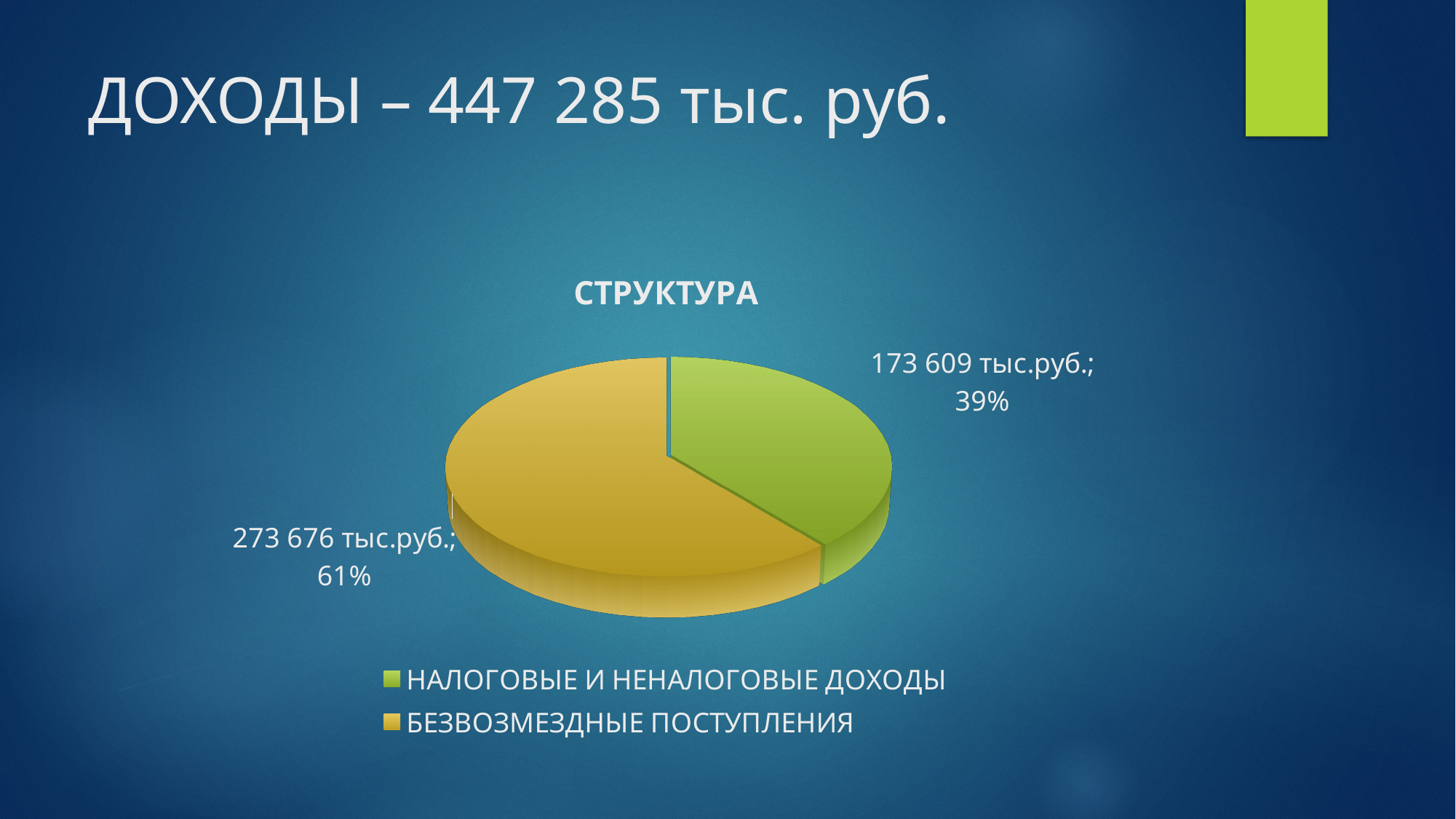
Which is larger, НАЛОГОВЫЕ И НЕНАЛОГОВЫЕ ДОХОДЫ or БЕЗВОЗМЕЗДНЫЕ ПОСТУПЛЕНИЯ? БЕЗВОЗМЕЗДНЫЕ ПОСТУПЛЕНИЯ What kind of chart is shown on the slide? Pie chart Which category has the largest slice? БЕЗВОЗМЕЗДНЫЕ ПОСТУПЛЕНИЯ What is the difference between БЕЗВОЗМЕЗДНЫЕ ПОСТУПЛЕНИЯ and НАЛОГОВЫЕ И НЕНАЛОГОВЫЕ ДОХОДЫ? 100 067 тыс.руб. What share of the pie does БЕЗВОЗМЕЗДНЫЕ ПОСТУПЛЕНИЯ represent? 61% Which category has the smallest slice? НАЛОГОВЫЕ И НЕНАЛОГОВЫЕ ДОХОДЫ Which colour represents БЕЗВОЗМЕЗДНЫЕ ПОСТУПЛЕНИЯ in the chart? Yellow What is the title of the chart? СТРУКТУРА How many slices does the pie chart have? 2 What is the value for НАЛОГОВЫЕ И НЕНАЛОГОВЫЕ ДОХОДЫ? 173 609 тыс.руб. What share of the pie does НАЛОГОВЫЕ И НЕНАЛОГОВЫЕ ДОХОДЫ represent? 39% What is the value for БЕЗВОЗМЕЗДНЫЕ ПОСТУПЛЕНИЯ? 273 676 тыс.руб.